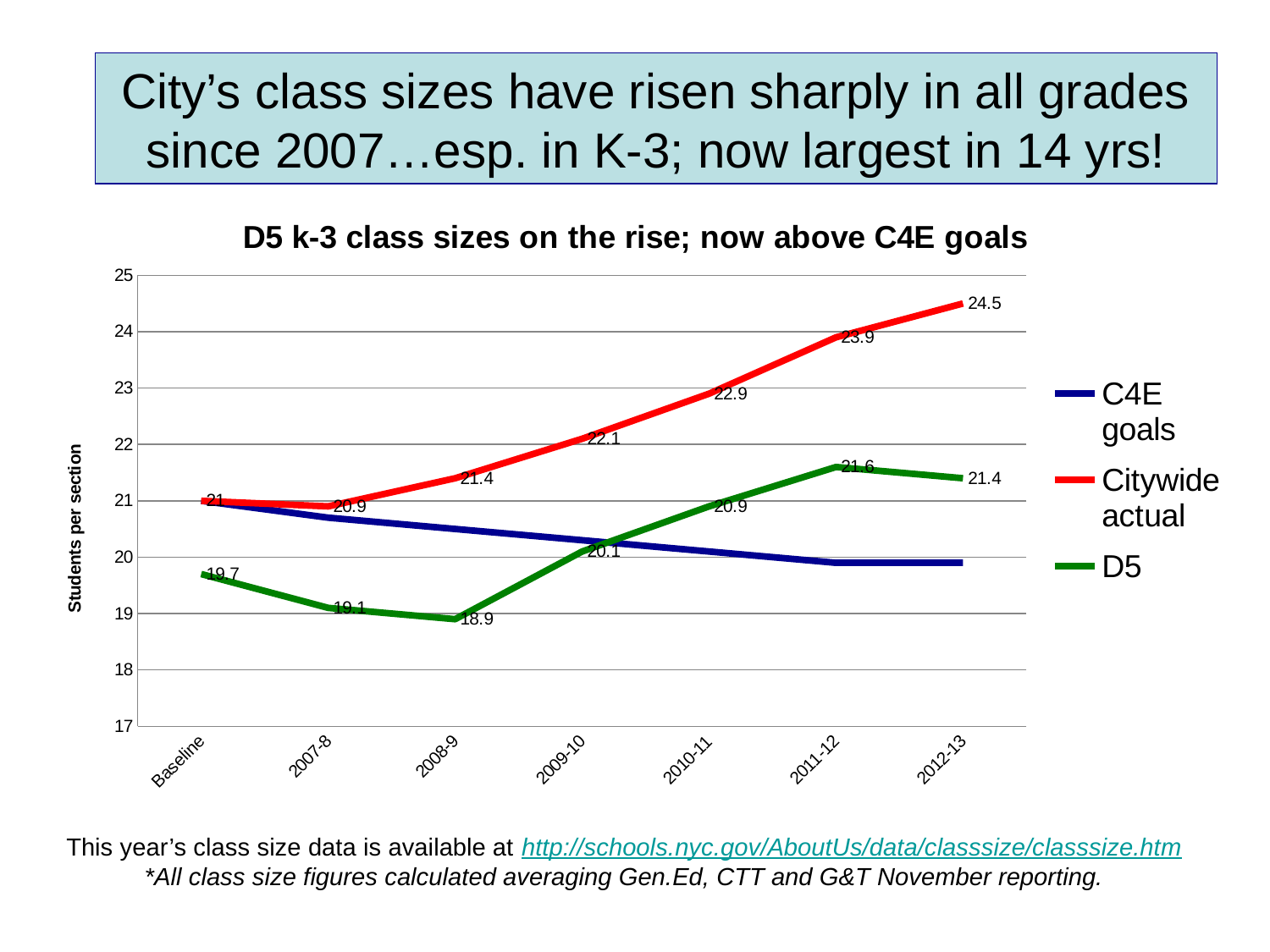
How many series does the legend list? 3 What is the D5 value for 2008-9? 18.9 What is the D5 value for 2011-12? 21.6 What kind of chart is shown on the slide? line chart How many time periods are shown on the x axis? 7 In which year is the D5 series at its highest? 2011-12 In 2012-13, which is larger: the D5 value or the Citywide actual value? Citywide actual How much higher is the Citywide actual value in 2012-13 than in 2007-8? 3.6 In which year is the D5 series at its lowest? 2008-9 What is the Citywide actual value for 2012-13? 24.5 What is the Citywide actual value for 2010-11? 22.9